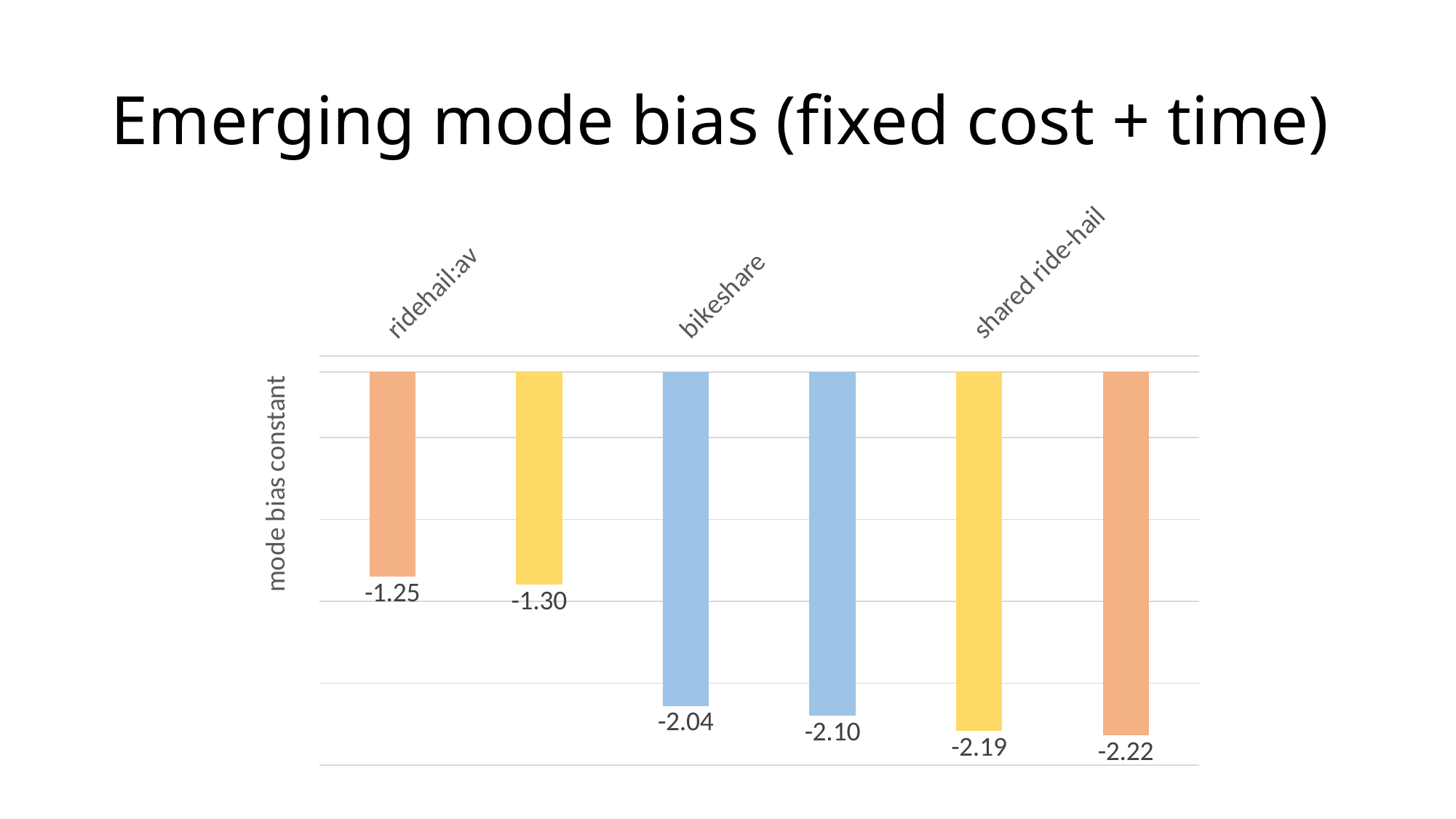
What is the title of the slide's chart? Emerging mode bias (fixed cost + time) What is the difference between the first bar for ridehail:av (-1.25) and the first bar for bikeshare (-2.04)? 0.79 Which bar has the lowest value in the chart? the rightmost bar (-2.22) What is the value of the first (left) bar for bikeshare? -2.04 What is the value of the first (left) bar for ridehail:av? -1.25 Which bar has the highest value in the chart? the first bar for ridehail:av (-1.25) What is the label on the vertical axis of the chart? mode bias constant What type of chart is shown on the slide? bar chart